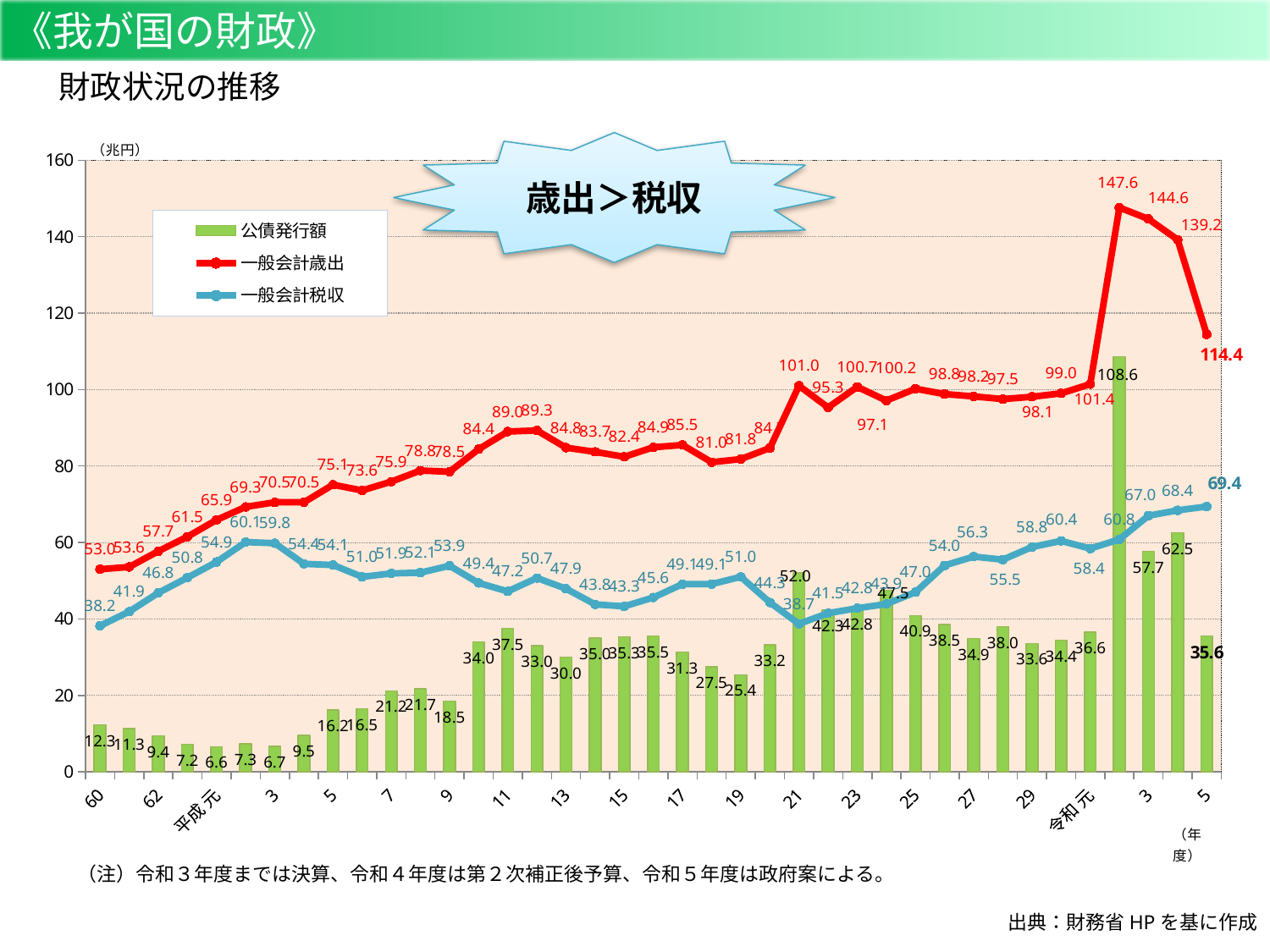
How many series does the legend list? 3 What is the difference between 一般会計歳出 and 一般会計税収 for 令和5年度? 45.0 What is the lowest value of 一般会計歳出 shown on the chart? 53.0 What is the value of 一般会計歳出 for 令和5年度? 114.4 What unit is shown at the top of the vertical axis? 兆円 What is the value of 一般会計税収 for 令和5年度? 69.4 What is the 公債発行額 for 令和5年度? 35.6 What is the highest 公債発行額 shown on the chart? 108.6 Which is larger, the 公債発行額 for 令和3年度 or for 令和4年度? 令和4年度 What is the highest value of 一般会計歳出 shown on the chart? 147.6 What is the 公債発行額 for 平成21年度? 52.0 What kind of chart is this? Combined bar and line chart